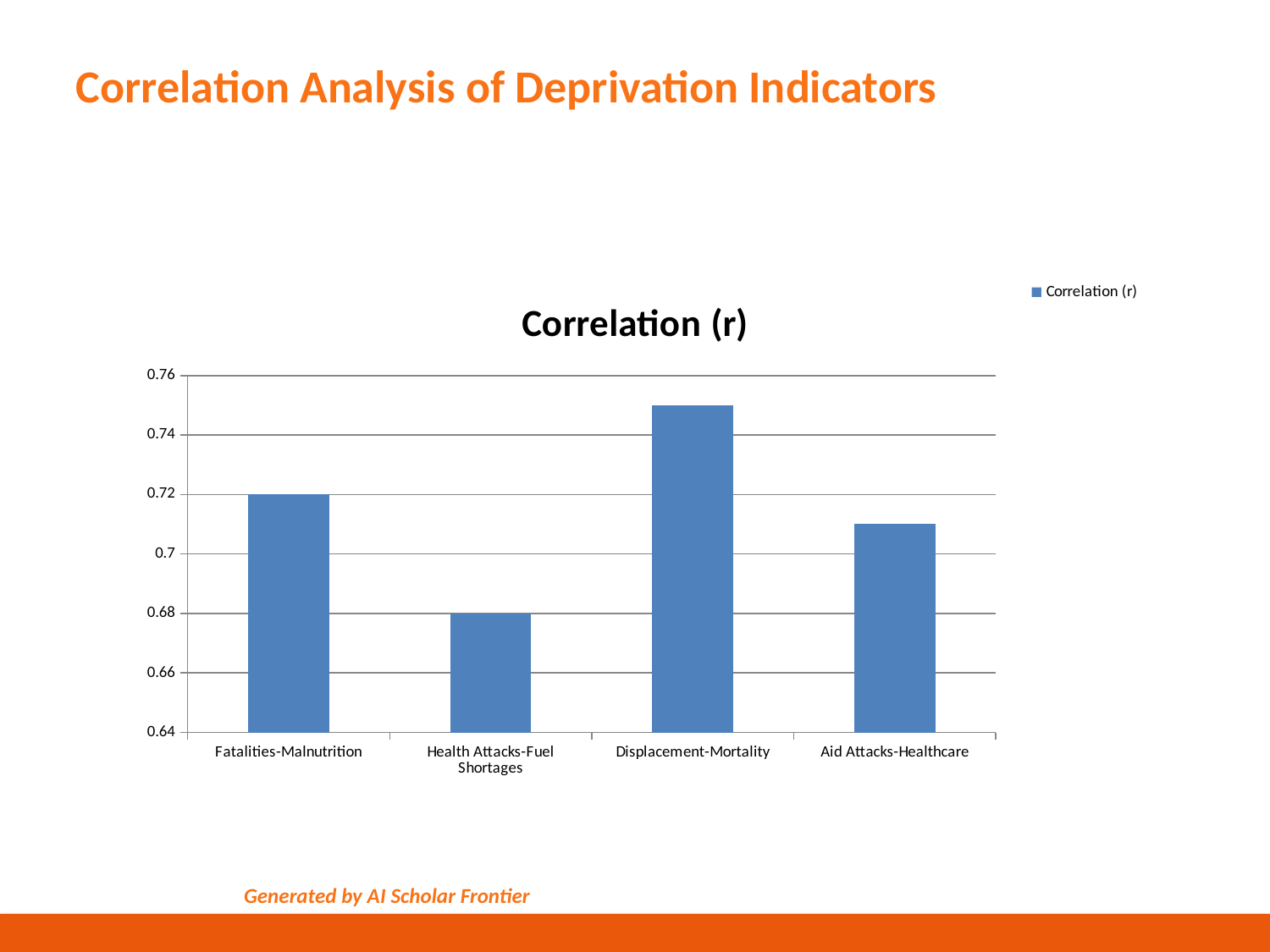
Is the value for Displacement-Mortality greater or less than 0.74? greater How many series does the legend list? 1 Which category has the highest correlation value? Displacement-Mortality What type of chart is shown on the slide? Bar chart How many categories are plotted on the x axis? 4 What is the correlation value for Health Attacks-Fuel Shortages? 0.68 Is the value for Aid Attacks-Healthcare greater or less than 0.7? greater What is the difference between the correlation values for Fatalities-Malnutrition and Health Attacks-Fuel Shortages? 0.04 What is the chart's title? Correlation (r) Which is larger, the value for Displacement-Mortality or the value for Fatalities-Malnutrition? Displacement-Mortality Which category has the lowest correlation value? Health Attacks-Fuel Shortages What is the correlation value for Fatalities-Malnutrition? 0.72